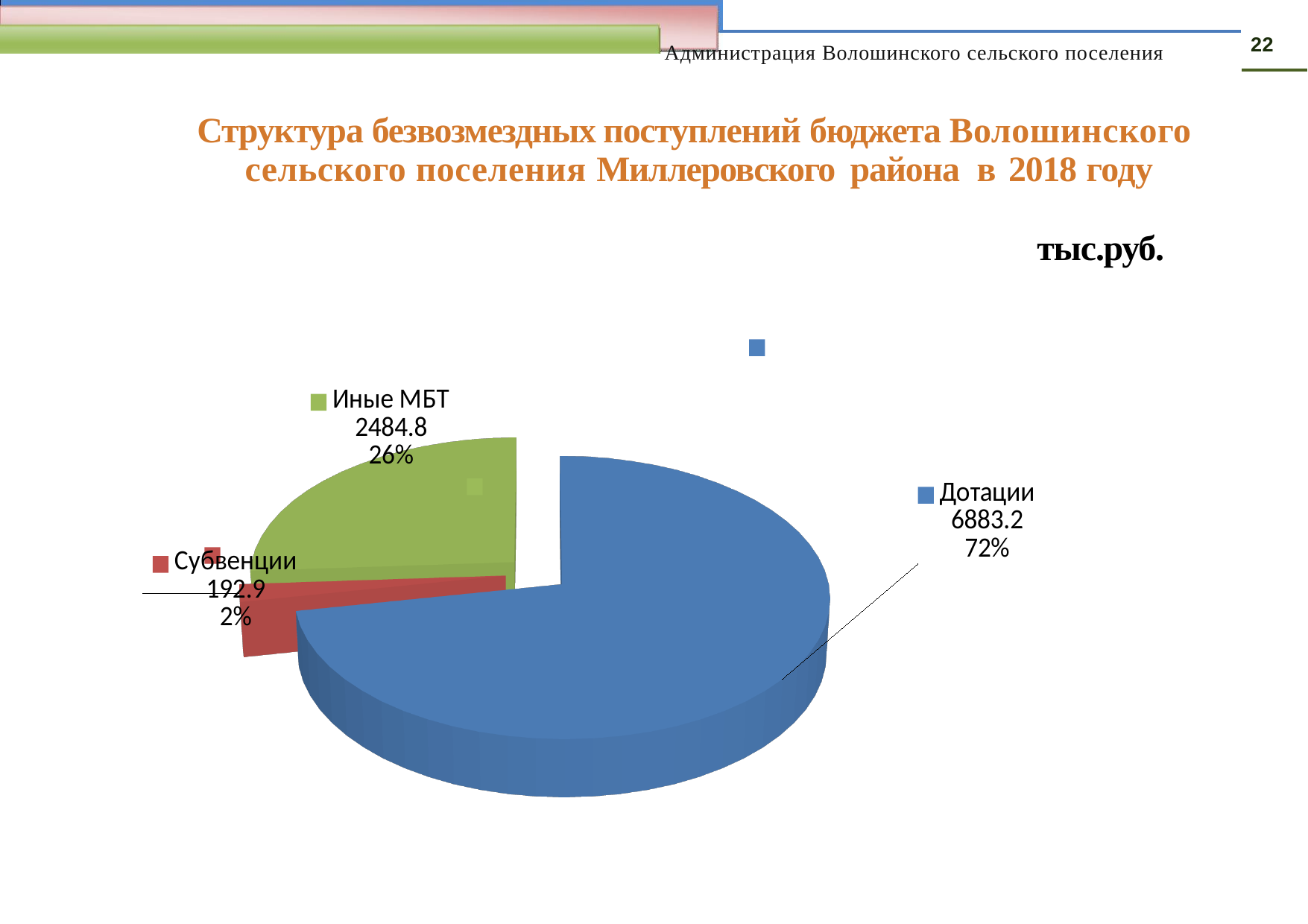
What type of chart is shown on the slide? Pie chart How many categories are shown in the pie chart? 3 What is the value for Дотации? 6883.2 What share of the pie does Дотации represent? 72% What is the value for Субвенции? 192.9 Which category has the largest slice of the pie? Дотации What unit of measurement is indicated for the chart values? тыс.руб. Which category has the smallest slice of the pie? Субвенции What is the difference between the values for Дотации and Иные МБТ? 4398.4 What is the value for Иные МБТ? 2484.8 What share of the pie does Субвенции represent? 2% What share of the pie does Иные МБТ represent? 26%